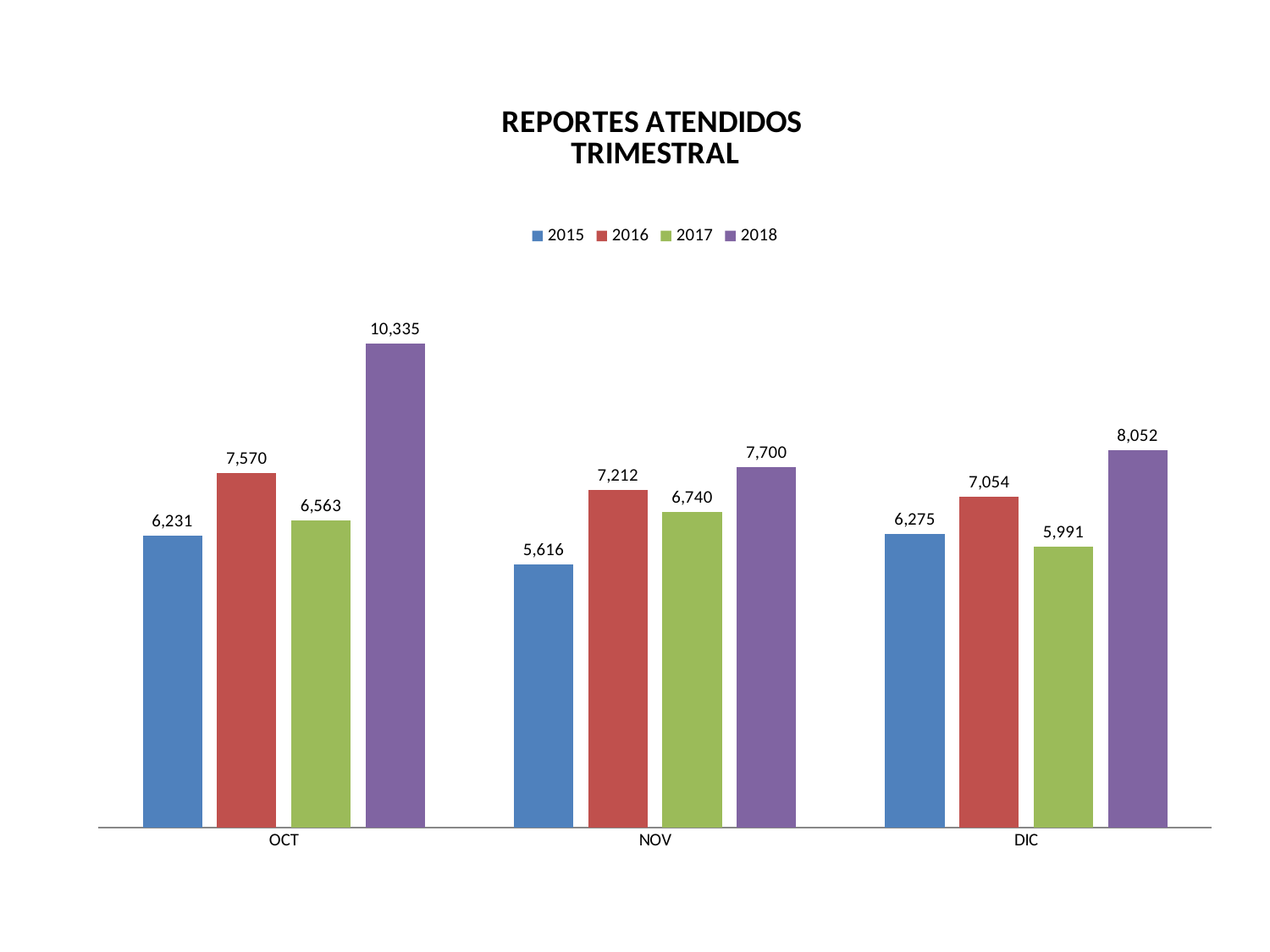
Which month has the highest value for 2018? OCT What is the value for 2015 in NOV? 5,616 What is the difference between the 2016 and 2017 values in NOV? 472 Which month has the lowest value for 2015? NOV What is the difference between the 2018 and 2015 values in OCT? 4,104 What is the value for 2018 in OCT? 10,335 How many series does the legend list? 4 How many months are shown on the x axis? 3 Which is larger in DIC: the value for 2016 or the value for 2017? 2016 What is the value for 2017 in DIC? 5,991 What is the title of the chart? REPORTES ATENDIDOS TRIMESTRAL What kind of chart is shown on the slide? Bar chart